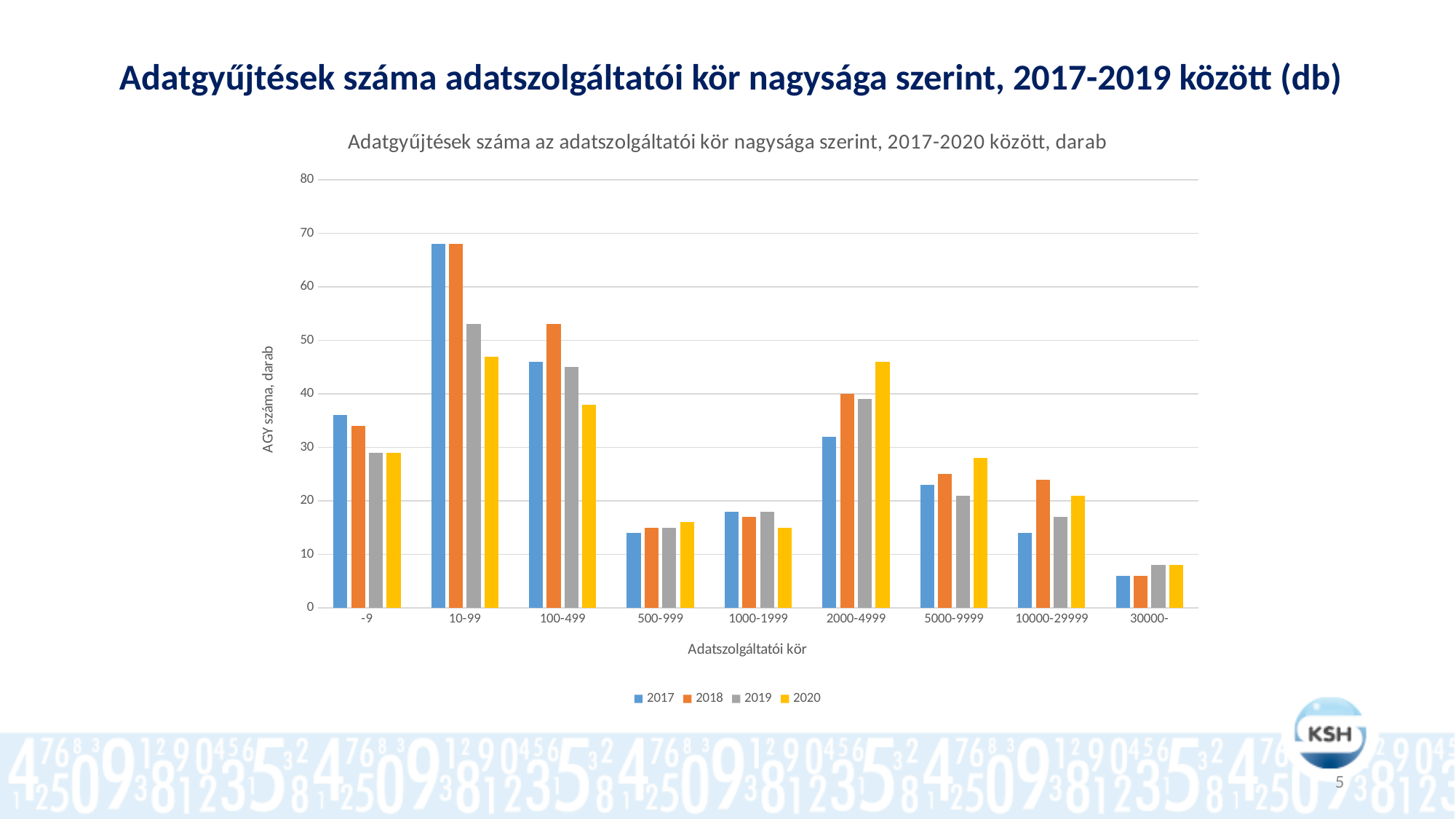
What kind of chart is shown on the slide? bar chart Is the value for 2019 in the 30000- category greater or less than 10? less How many categories are shown on the x axis? 9 In the 100-499 category, which is larger: the value for 2018 or for 2020? 2018 What is the label of the x axis? Adatszolgáltatói kör Is the value for 2017 in the 10-99 category greater or less than 60? greater In the 2000-4999 category, which is larger: the value for 2017 or for 2020? 2020 Which category has the highest value for 2017? 10-99 How many series does the legend list? 4 Which category has the lowest value for 2018? 30000- What is the label of the y axis? AGY száma, darab Is the value for 2020 in the 2000-4999 category greater or less than 40? greater